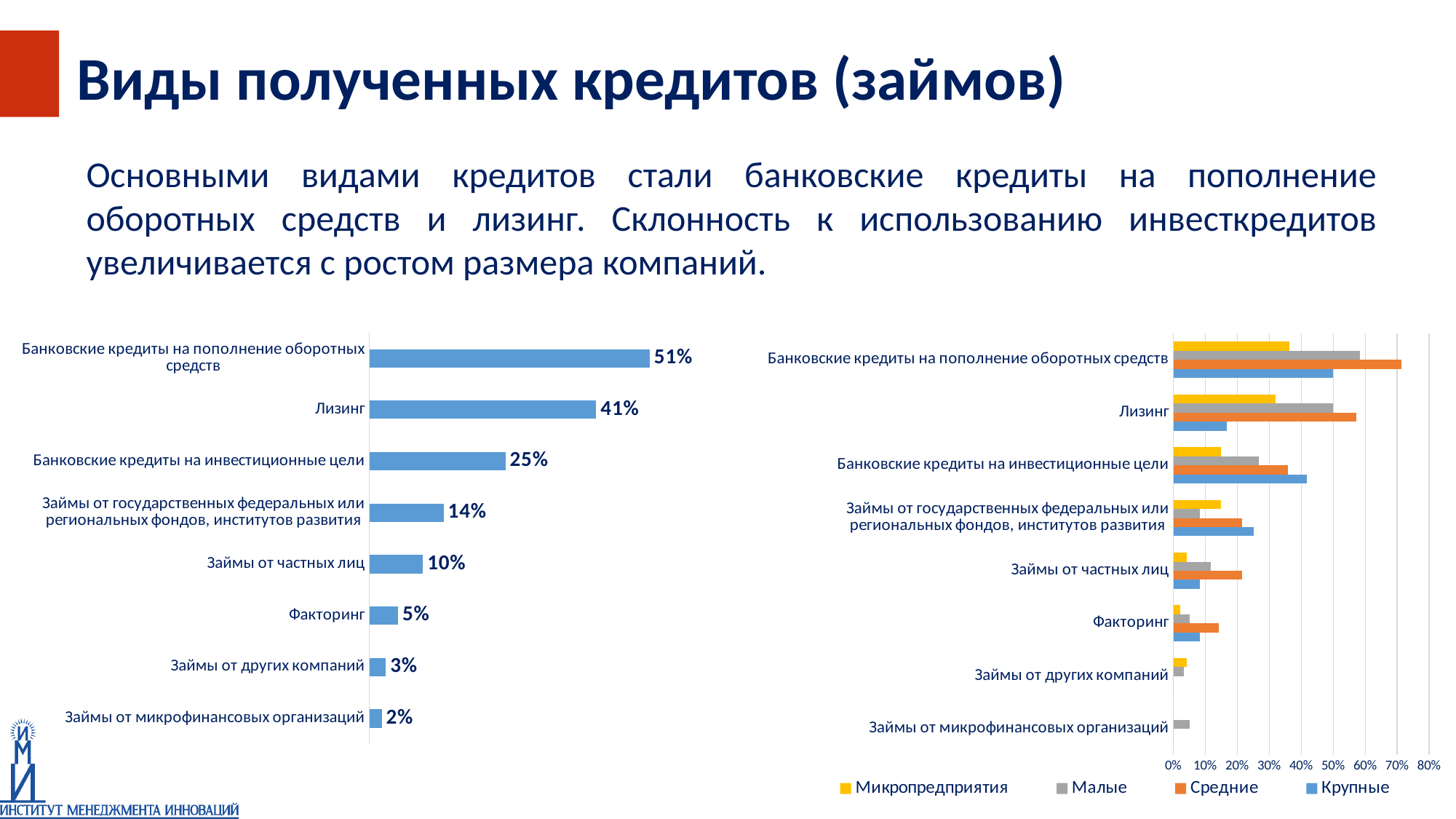
In the left chart, what is the difference between the values for Банковские кредиты на пополнение оборотных средств and Лизинг? 10% In the left chart, what is the value for Займы от частных лиц? 10% How many series does the legend of the right chart list? 4 In the right chart, is the value for Средние for Банковские кредиты на пополнение оборотных средств greater or less than 60%? greater In the right chart, for Лизинг, which is larger: the value for Средние or the value for Крупные? Средние What kind of chart is the left chart? Bar chart How many categories are shown in the left chart? 8 In the left chart, which is larger: the value for Факторинг or the value for Займы от других компаний? Факторинг In the right chart, is the value for Крупные for Лизинг greater or less than 20%? less In the left chart, which category has the highest value? Банковские кредиты на пополнение оборотных средств In the left chart, what is the value for Лизинг? 41% In the left chart, which category has the lowest value? Займы от микрофинансовых организаций